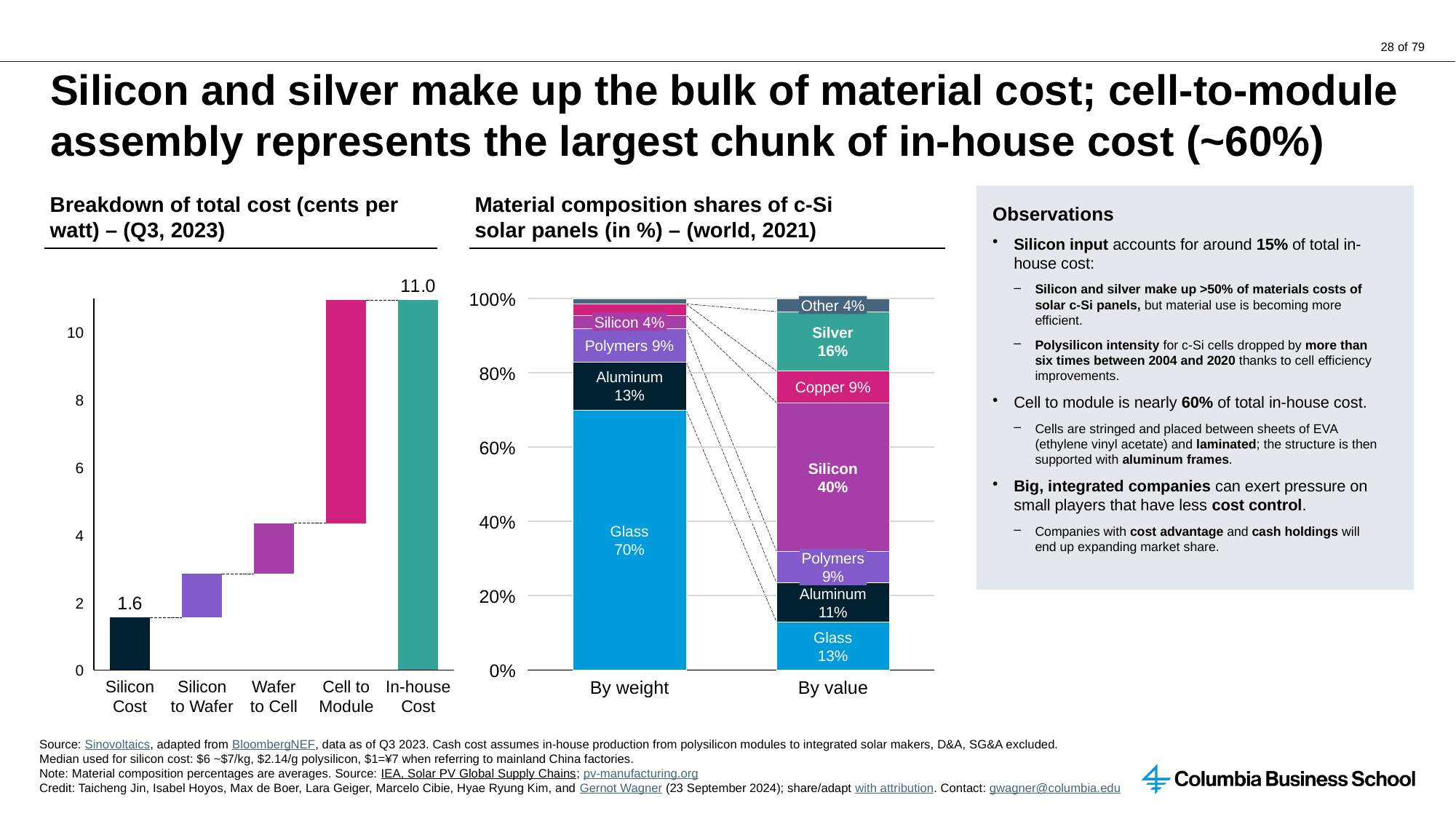
In the 'Breakdown of total cost (cents per watt)' chart, what is the value shown for In-house Cost? 11.0 In the 'Material composition shares of c-Si solar panels' chart, what is the share of Silicon by value? 40% In the 'Material composition shares of c-Si solar panels' chart, how many percentage points higher is the Glass share by weight than by value? 57 How many categories are shown on the x axis of the 'Breakdown of total cost (cents per watt)' chart? 5 In the 'Material composition shares of c-Si solar panels' chart, what is the share of Glass by weight? 70% In the 'Material composition shares of c-Si solar panels' chart, which material has the largest share by value? Silicon What kind of chart is the 'Material composition shares of c-Si solar panels' chart? Stacked bar chart How many stacked bars are shown in the 'Material composition shares of c-Si solar panels' chart? 2 In the 'Breakdown of total cost (cents per watt)' chart, is the top of the Wafer to Cell bar greater or less than 6? less In the 'Material composition shares of c-Si solar panels' chart, which has the larger share by value, Silver or Copper? Silver In the 'Breakdown of total cost (cents per watt)' chart, what is the difference between the In-house Cost and the Silicon Cost? 9.4 In the 'Breakdown of total cost (cents per watt)' chart, what is the value shown for Silicon Cost? 1.6